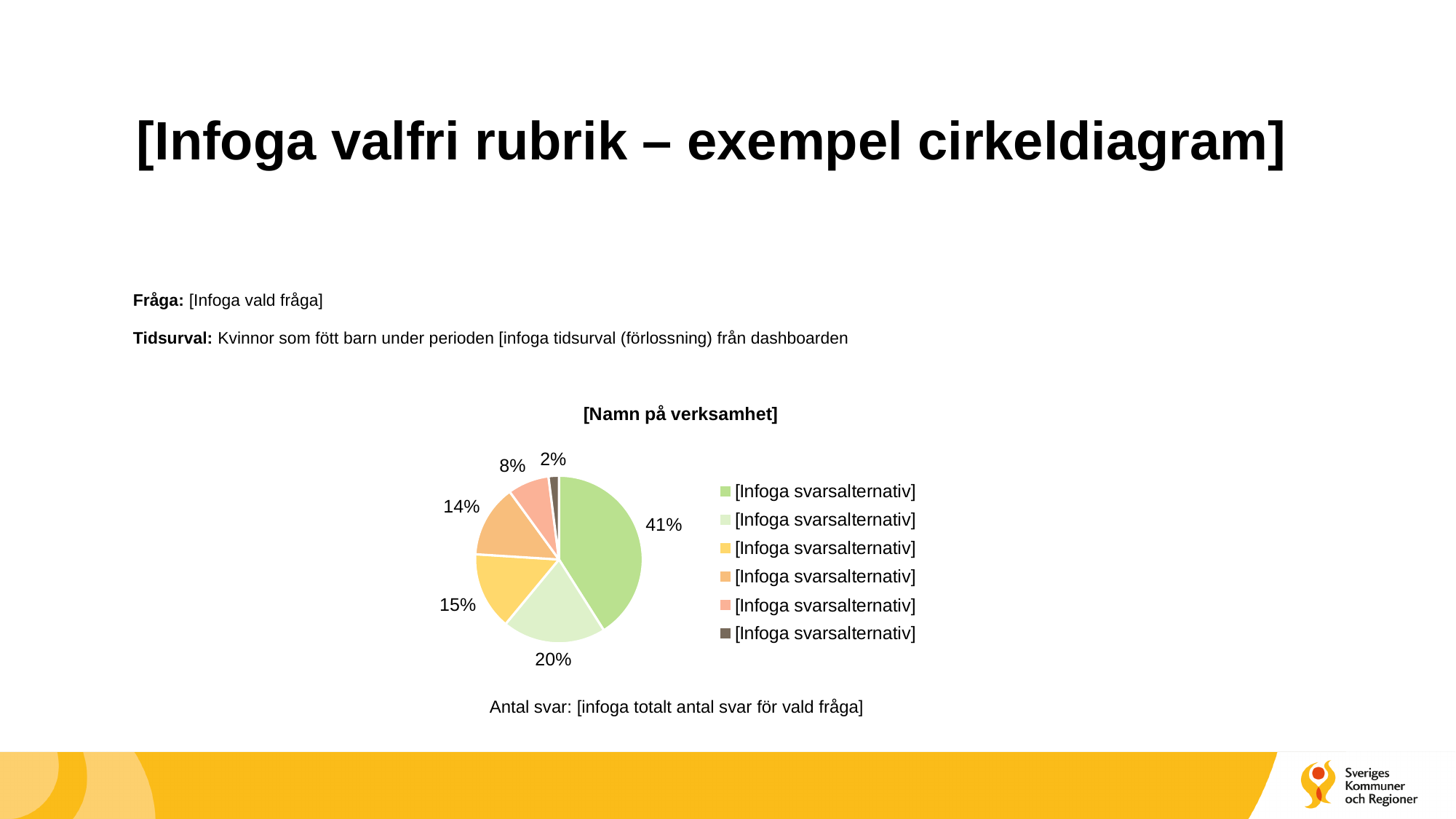
What share does the yellow slice of the pie chart represent? 15% What share does the brown slice of the pie chart represent? 2% How many entries does the legend of the pie chart list? 6 What kind of chart is shown on the slide? pie chart What share does the light green slice of the pie chart represent? 20% How many slices does the pie chart have? 6 What is the title of the pie chart? [Namn på verksamhet] What is the smallest share shown in the pie chart? 2% What is the largest share shown in the pie chart? 41% What is the difference between the largest slice (41%) and the second largest slice (20%) in the pie chart? 21% Which is larger in the pie chart, the orange slice or the salmon-coloured slice? the orange slice (14%)